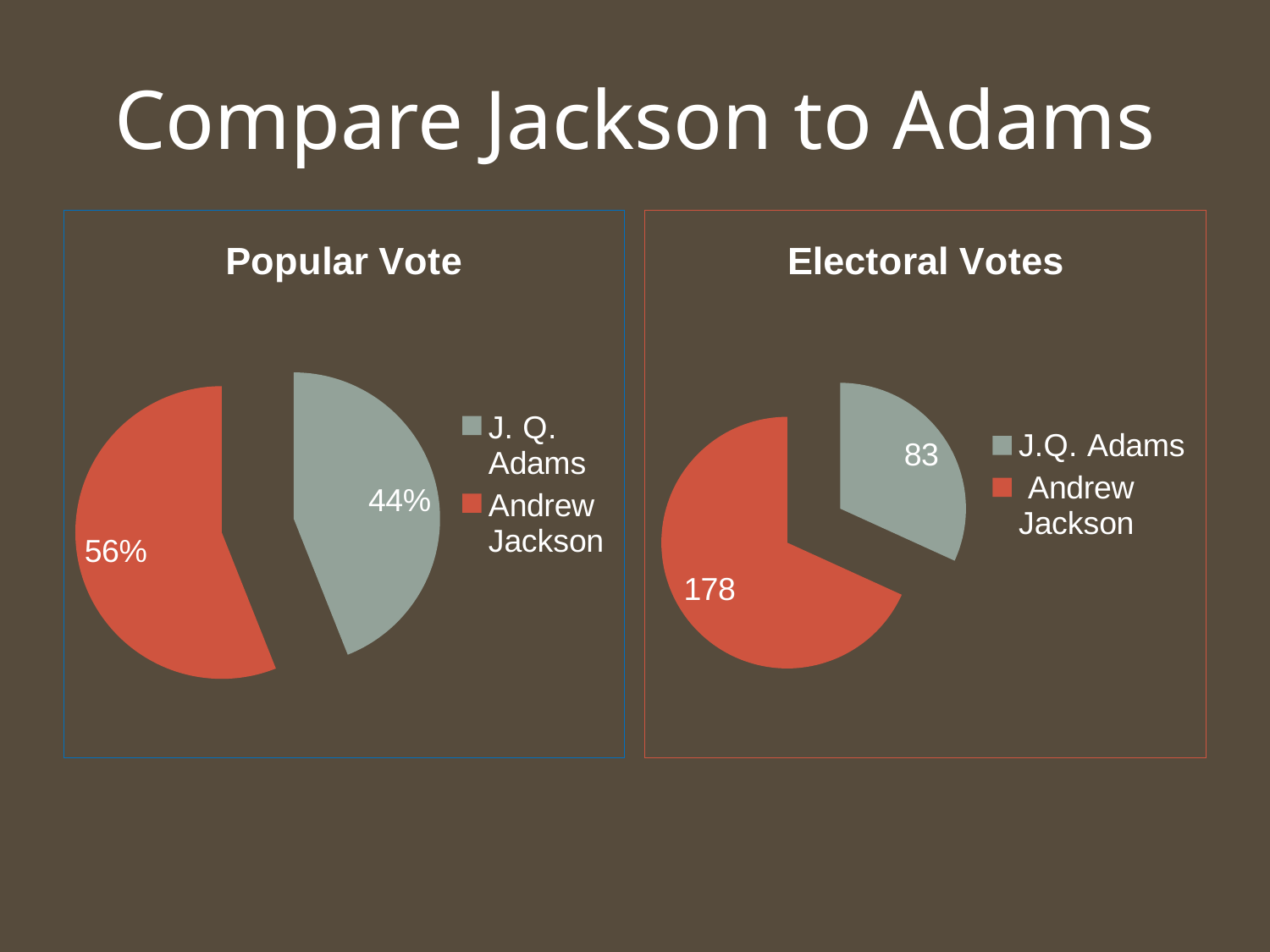
How many slices does the Electoral Votes pie chart have? 2 In the Popular Vote chart, which colour represents Andrew Jackson? Red In the Electoral Votes chart, which candidate has the larger slice? Andrew Jackson In the Electoral Votes chart, what is the total number of electoral votes shown? 261 In the Electoral Votes chart, how many electoral votes does J.Q. Adams have? 83 In the Popular Vote chart, what share does J. Q. Adams have? 44% In the Electoral Votes chart, what is the difference between Andrew Jackson's and J.Q. Adams's electoral votes? 95 In the Popular Vote chart, what is the difference between Andrew Jackson's and J. Q. Adams's shares? 12% What kind of chart is the Popular Vote chart? Pie chart In the Popular Vote chart, what share does Andrew Jackson have? 56% In the Electoral Votes chart, how many electoral votes does Andrew Jackson have? 178 In the Popular Vote chart, which candidate has the smaller slice? J. Q. Adams